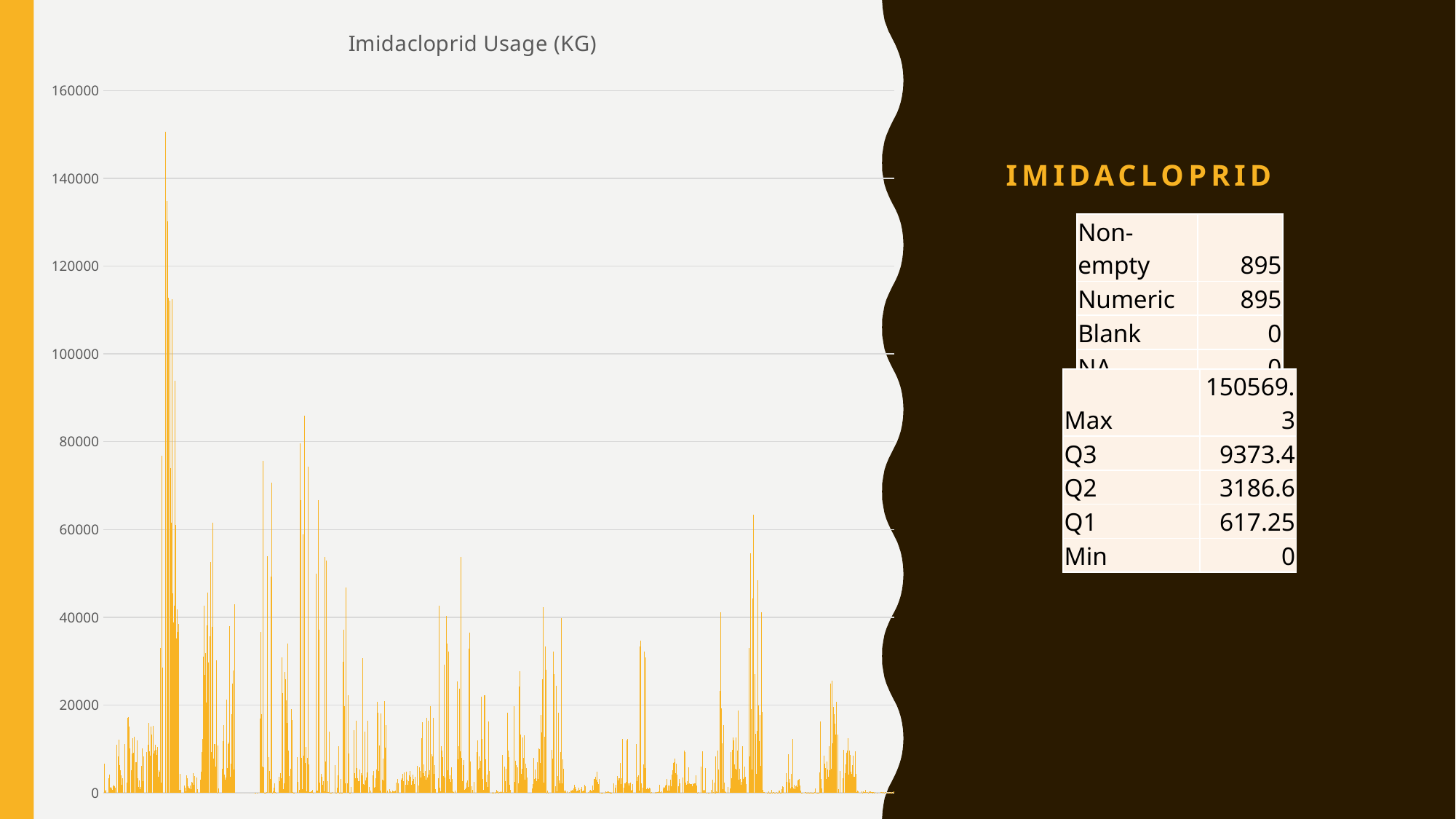
What kind of chart is shown on the slide? bar chart Is the second-tallest bar on the chart greater or less than 120000? greater What is the title of the chart? Imidacloprid Usage (KG) Is the tallest bar on the chart greater or less than 140000? greater Is the tallest bar on the chart greater or less than 160000? less What is the highest value labelled on the vertical axis of the chart? 160000